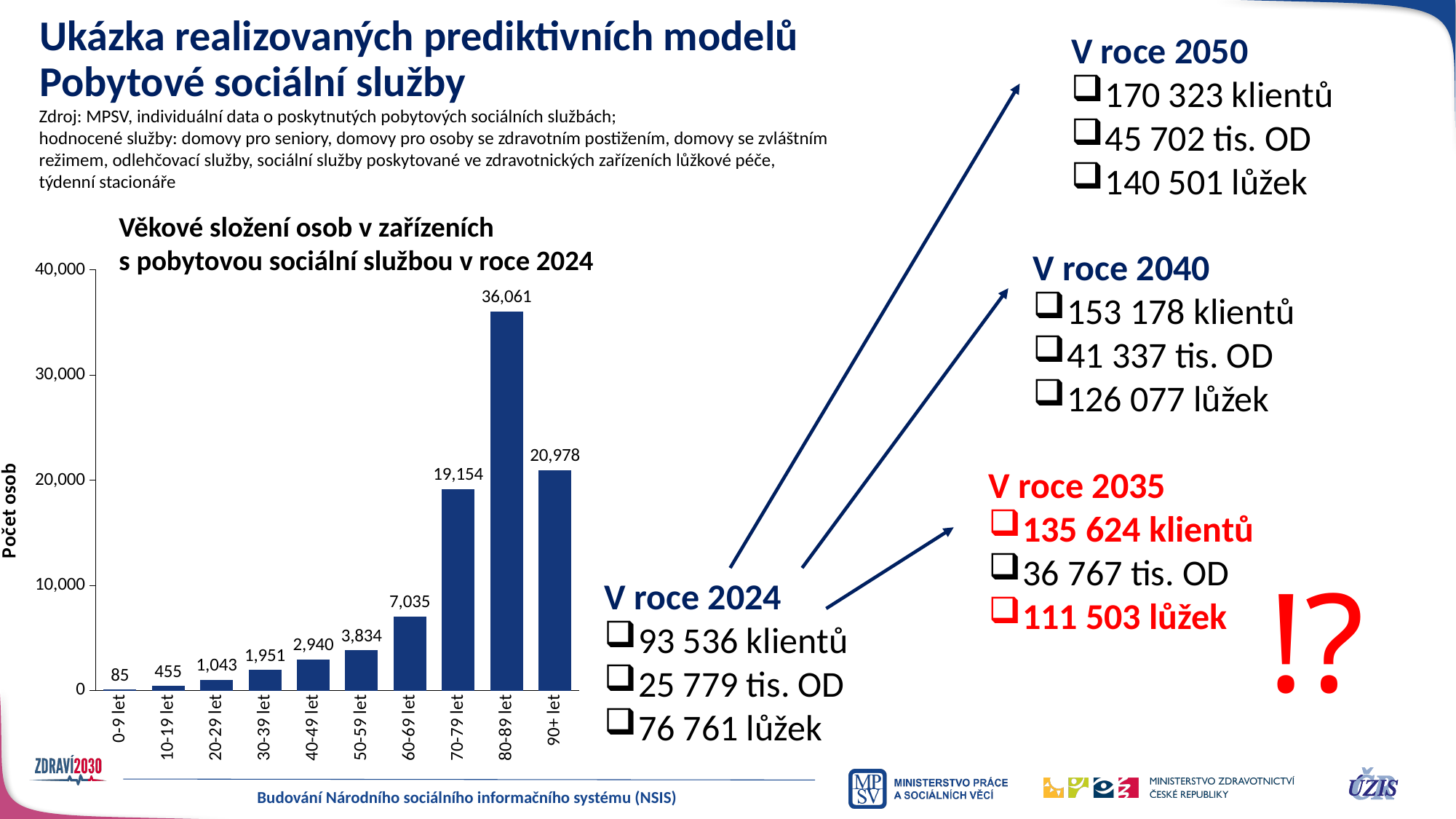
How many age categories are shown on the x axis of the chart? 10 What is the value for the 90+ let category? 20,978 Is the value for 50-59 let greater or less than 10,000? less What is the value for the 0-9 let category? 85 What type of chart is shown on the slide? bar chart Which age category has the highest value? 80-89 let What is the difference between the values for 80-89 let and 70-79 let? 16,907 What is the value for the 80-89 let category? 36,061 What is the value for the 60-69 let category? 7,035 Which age category has the lowest value? 0-9 let Which is larger, the value for 90+ let or the value for 70-79 let? 90+ let What is the label of the y axis of the chart? Počet osob